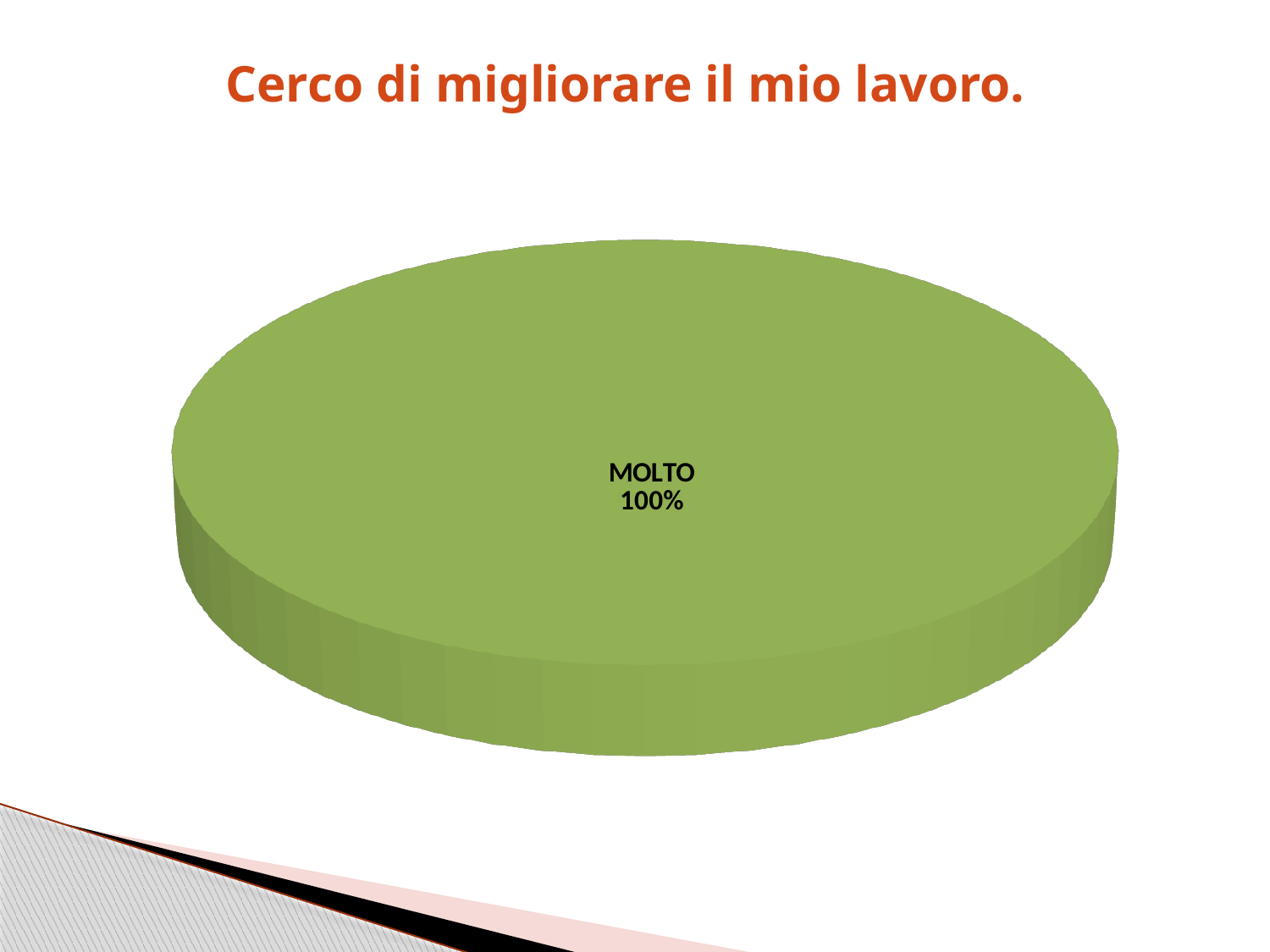
What kind of chart is shown on the slide? pie chart Which category is the largest slice of the pie chart? MOLTO What is the title of the slide above the chart? Cerco di migliorare il mio lavoro. What is the label of the only slice in the pie chart? MOLTO What share of the pie does the MOLTO slice represent? 100% How many slices does the pie chart have? 1 What colour is the MOLTO slice of the pie chart? green